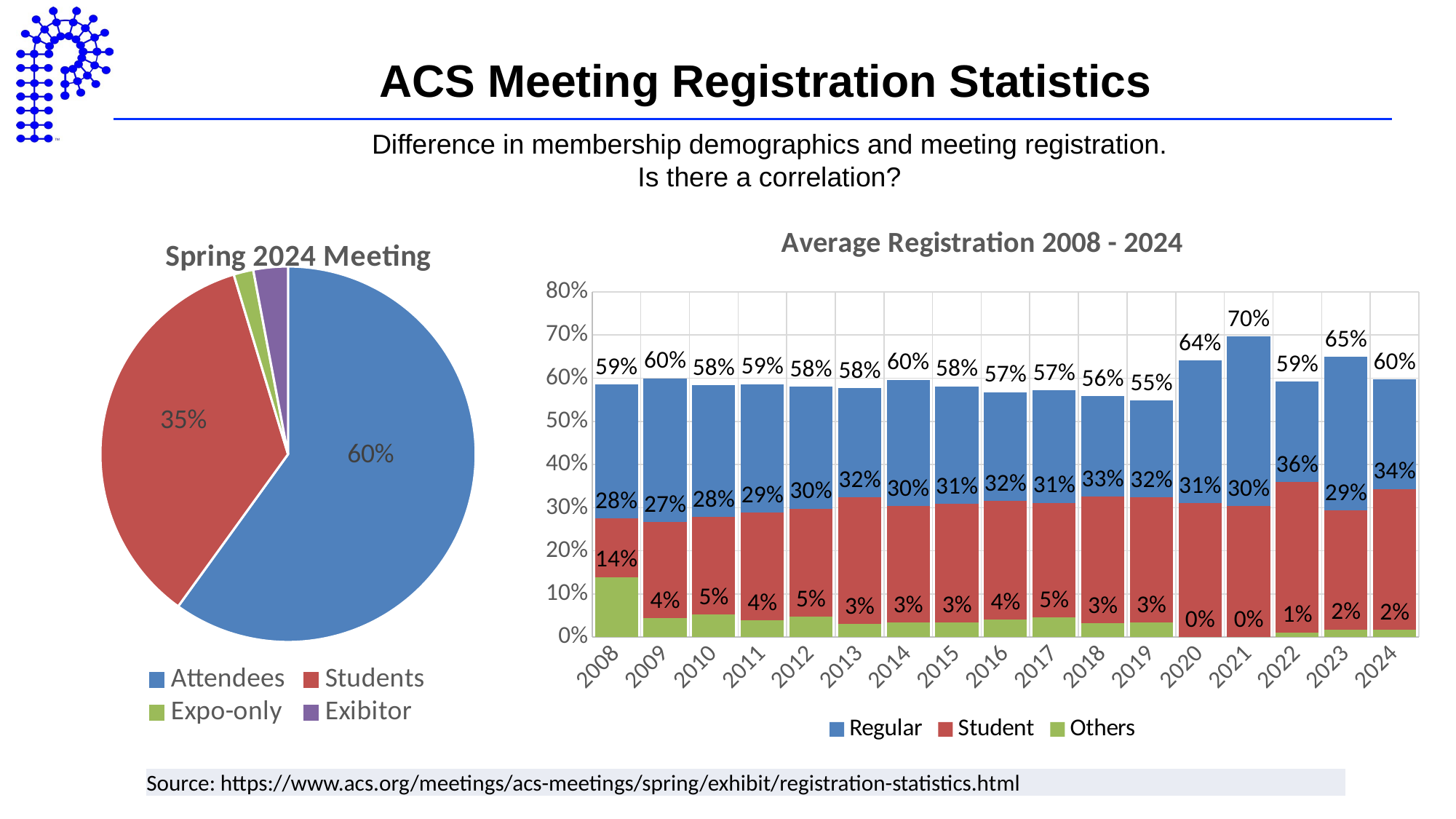
What kind of chart is 'Spring 2024 Meeting'? pie chart In the 'Spring 2024 Meeting' chart, which category has the largest slice? Attendees In the 'Spring 2024 Meeting' chart, what share of the pie is Attendees? 60% In the 'Average Registration 2008 - 2024' chart, which year has the highest Regular value? 2021 How many categories does the legend of the 'Spring 2024 Meeting' chart list? 4 In the 'Average Registration 2008 - 2024' chart, what is the difference between the Student values for 2022 and 2008? 8% In the 'Average Registration 2008 - 2024' chart, what is the Regular value for 2021? 70% In the 'Average Registration 2008 - 2024' chart, how many series does the legend list? 3 In the 'Average Registration 2008 - 2024' chart, what is the Others value for 2008? 14% In the 'Average Registration 2008 - 2024' chart, how many years are shown on the x axis? 17 In the 'Spring 2024 Meeting' chart, what share of the pie is Students? 35% In the 'Average Registration 2008 - 2024' chart, which year has the lowest Regular value? 2019